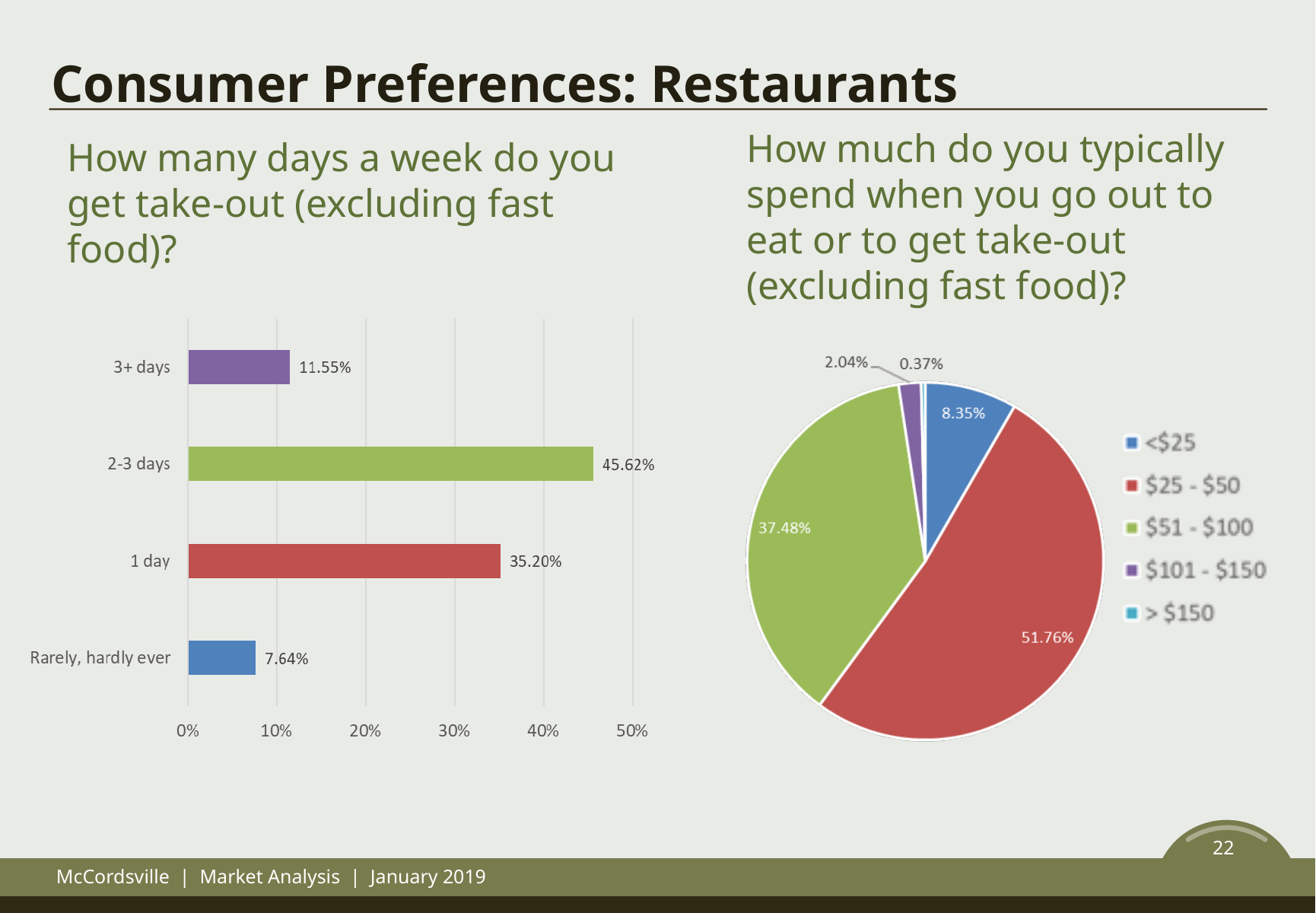
In the left chart on how many days a week people get take-out, which category has the lowest percentage? Rarely, hardly ever In the left chart on how many days a week people get take-out, what percentage of respondents chose 'Rarely, hardly ever'? 7.64% In the left chart on how many days a week people get take-out, what is the difference between the 2-3 days and 1 day percentages? 10.42% In the right pie chart on typical spending, what share of respondents spend $51 - $100? 37.48% What type of chart is the left chart on how many days a week people get take-out? Bar chart In the right pie chart on typical spending, which spending range has the smallest slice? > $150 In the left chart on how many days a week people get take-out, what percentage of respondents chose 2-3 days? 45.62% In the left chart on how many days a week people get take-out, how many categories are shown? 4 In the left chart on how many days a week people get take-out, which is larger: 3+ days or 1 day? 1 day In the right pie chart on typical spending, what share of respondents spend $25 - $50? 51.76% How many spending ranges does the legend of the right pie chart list? 5 In the left chart on how many days a week people get take-out, which category has the highest percentage? 2-3 days